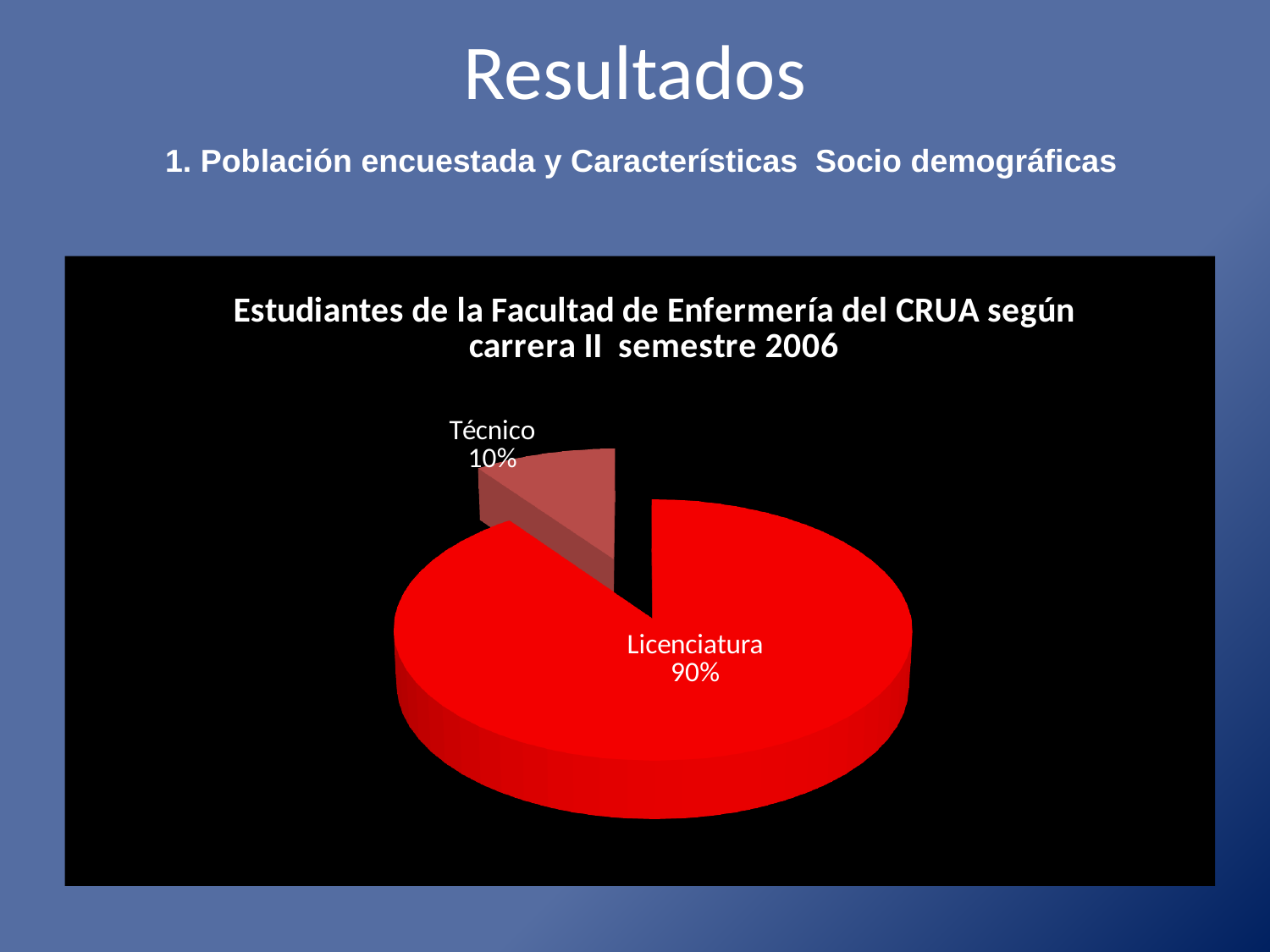
How many categories are shown in the pie chart? 2 What share of the pie does Técnico represent? 10% Which category has the smallest slice of the pie? Técnico Which is larger, the share for Licenciatura or the share for Técnico? Licenciatura What share of the pie does Licenciatura represent? 90% What is the title of the chart? Estudiantes de la Facultad de Enfermería del CRUA según carrera II semestre 2006 What is the difference in percentage points between Licenciatura and Técnico? 80 What colour is the Licenciatura slice? Red What kind of chart is shown on the slide? Pie chart Which category has the largest slice of the pie? Licenciatura